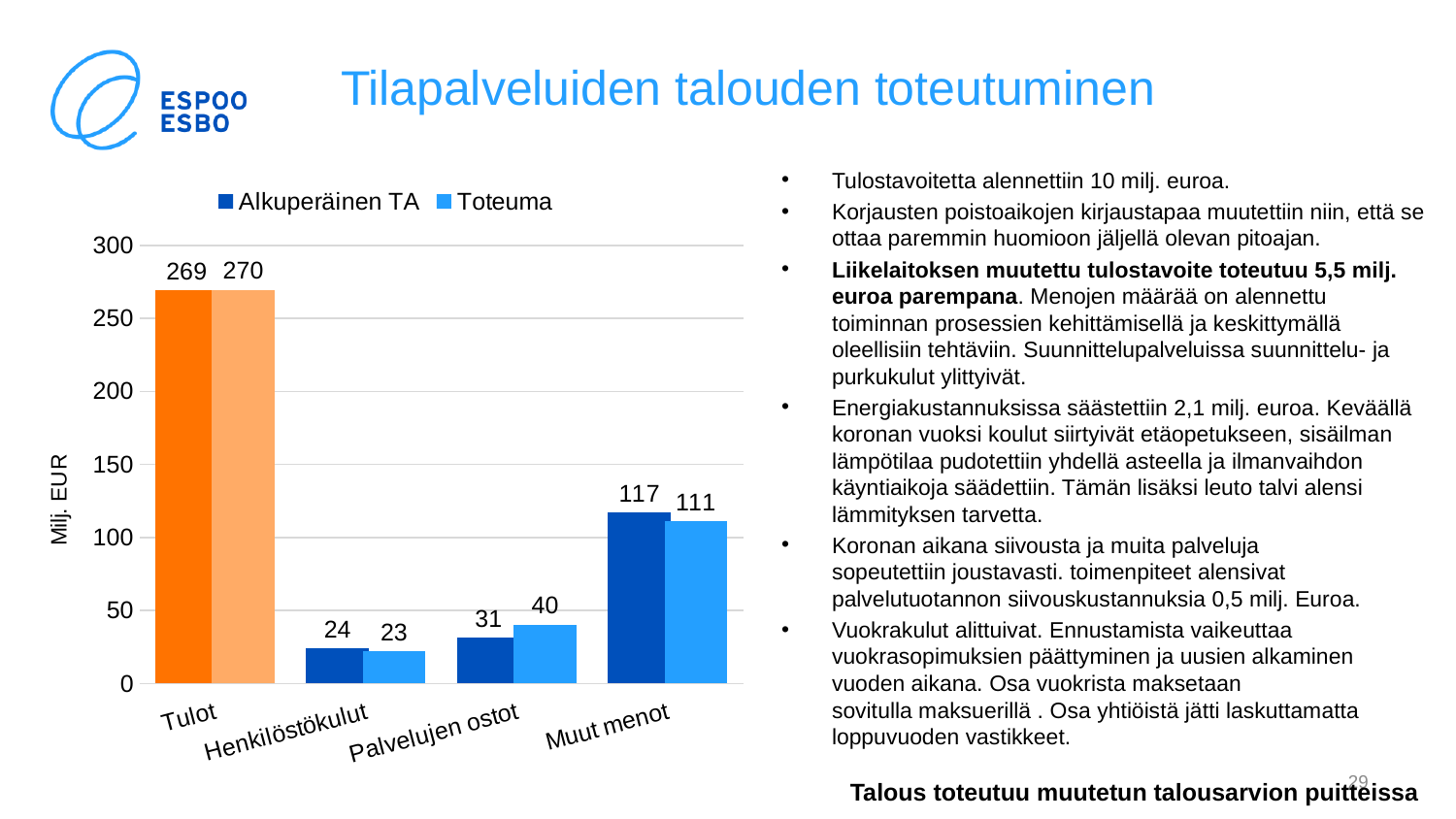
How many categories are shown on the x axis? 4 What is the label of the y axis? Milj. EUR What is the Alkuperäinen TA value for Henkilöstökulut? 24 What is the difference between the Alkuperäinen TA and Toteuma values for Muut menot? 6 What is the Toteuma value for Muut menot? 111 What is the Alkuperäinen TA value for Tulot? 269 How many series does the legend list? 2 What kind of chart is shown on the slide? Bar chart Which category has the lowest Alkuperäinen TA value? Henkilöstökulut Which category has the highest Toteuma value? Tulot Which is larger for Palvelujen ostot: Alkuperäinen TA or Toteuma? Toteuma What is the Toteuma value for Palvelujen ostot? 40